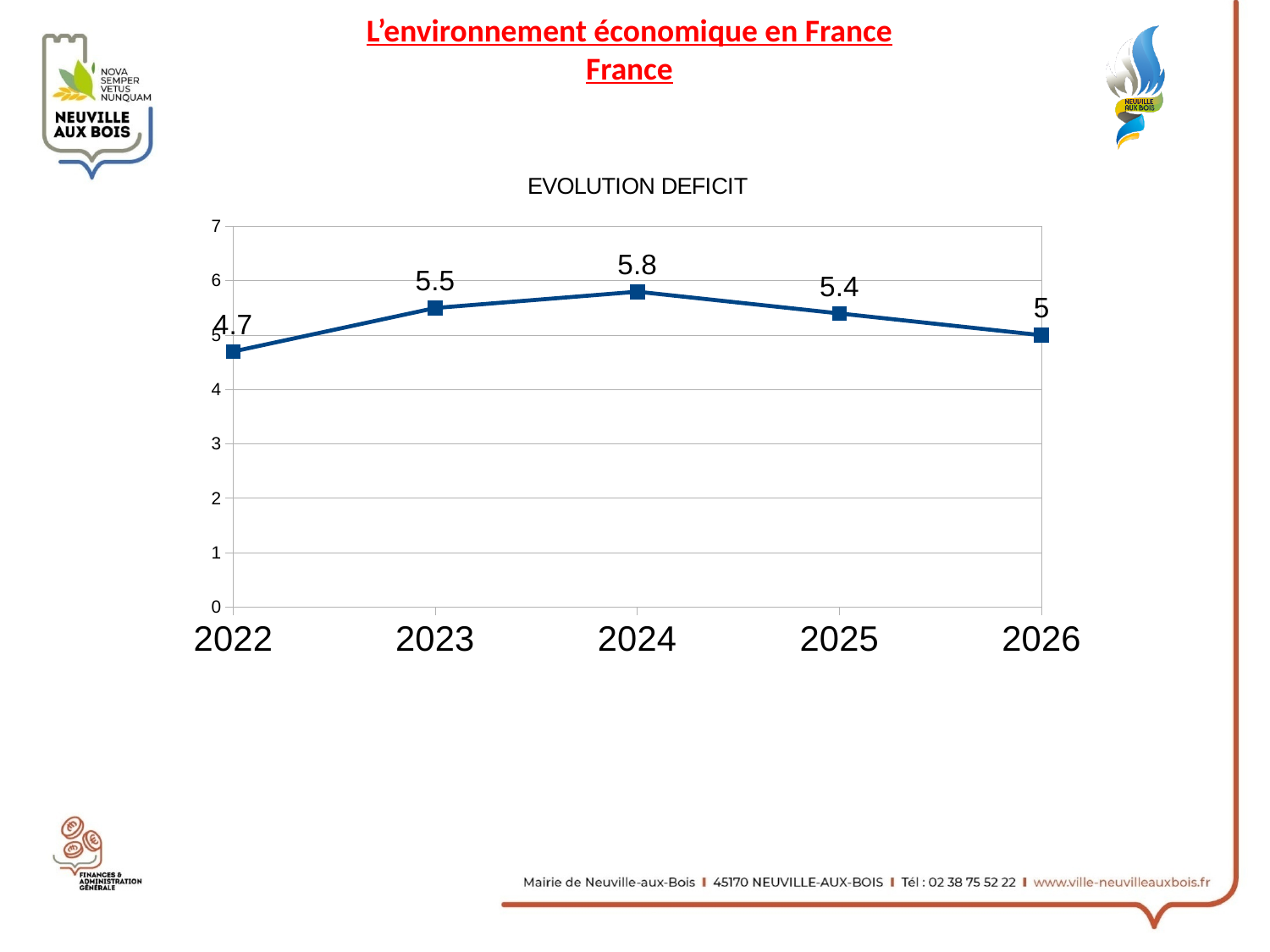
What is the title of the chart? EVOLUTION DEFICIT What is the difference between the values for 2024 and 2022? 1.1 How many years are plotted on the chart? 5 Which year has the highest value? 2024 What is the value for 2024? 5.8 Which is larger, the value for 2023 or the value for 2025? 2023 What kind of chart is shown? line chart Do the values rise or fall from 2024 to 2026? fall Is the value for 2022 greater or less than 5? less What is the value for 2022? 4.7 Which year has the lowest value? 2022 What is the value for 2026? 5